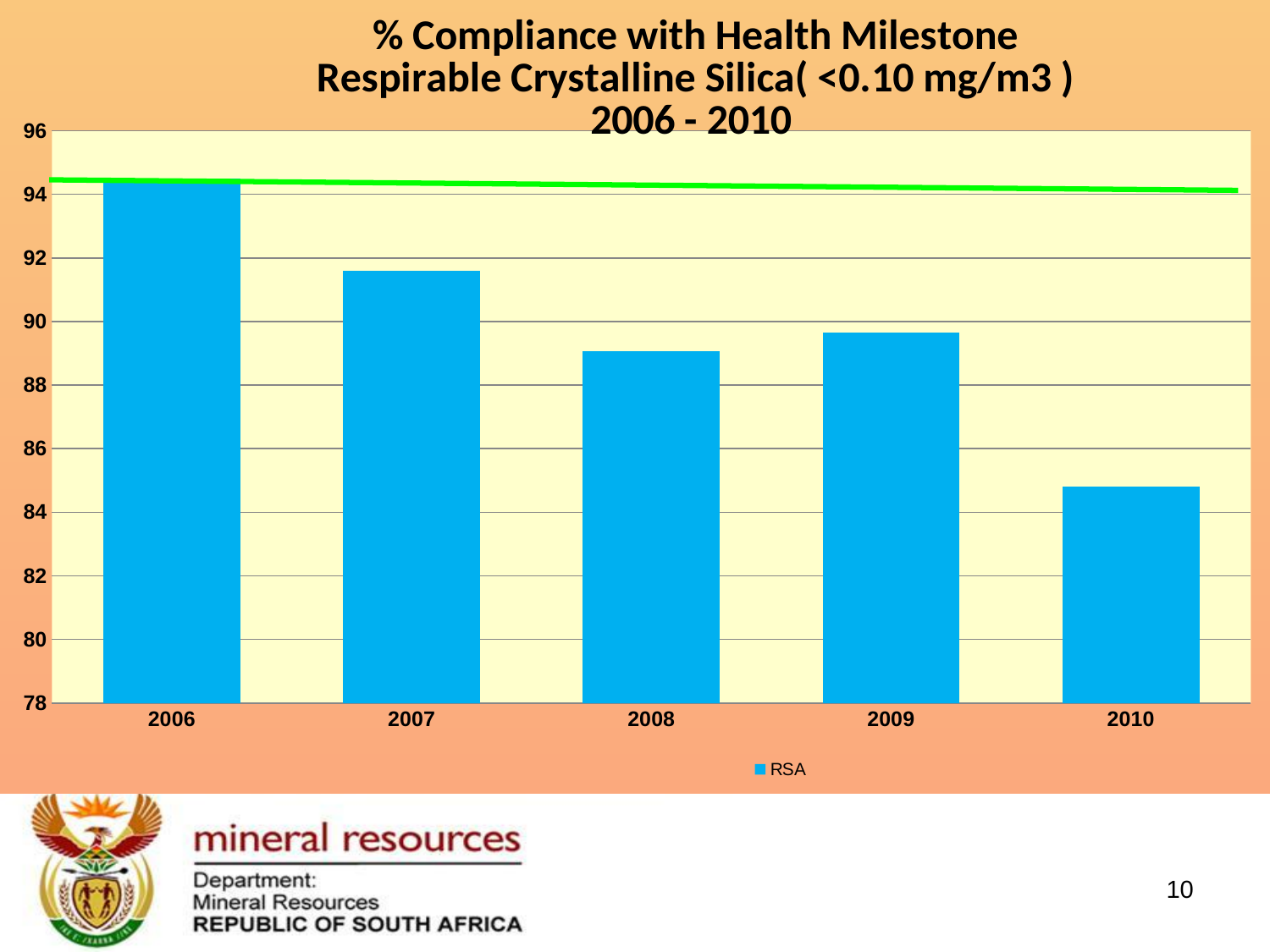
What kind of chart is shown on the slide? bar chart Is the value for 2007 greater or less than 90? greater Is the value for 2008 greater or less than 90? less Which year has the lowest % compliance in the chart? 2010 Which year has the highest % compliance in the chart? 2006 Is the value for 2006 greater or less than 92? greater How many series does the chart legend list? 1 Overall, do the bar values rise or fall from 2006 to 2010? fall How many years are shown on the x axis of the chart? 5 What series name is shown in the chart legend? RSA Which year has the larger value, 2007 or 2009? 2007